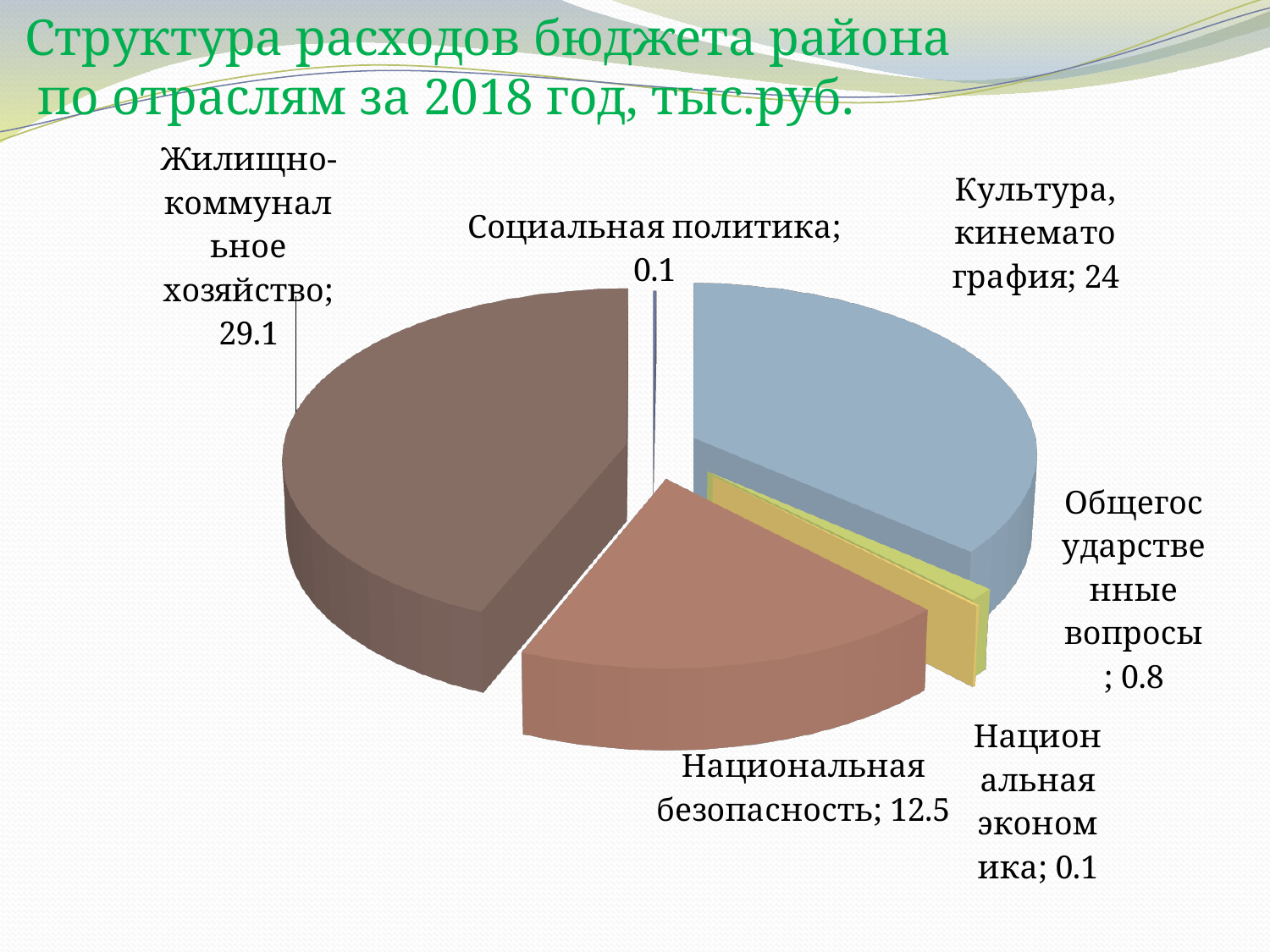
Which category has the highest value? Жилищно-коммунальное хозяйство What is the value for Жилищно-коммунальное хозяйство? 29.1 What is the value for Социальная политика? 0.1 Which is larger: Культура, кинематография or Национальная безопасность? Культура, кинематография What is the value for Культура, кинематография? 24 What is the value for Общегосударственные вопросы? 0.8 What is the title of the chart on the slide? Структура расходов бюджета района по отраслям за 2018 год, тыс.руб. What is the value for Национальная безопасность? 12.5 How many categories does the pie chart show? 6 What is the difference between Культура, кинематография and Национальная безопасность? 11.5 What is the difference between Жилищно-коммунальное хозяйство and Культура, кинематография? 5.1 What kind of chart is shown on the slide? pie chart